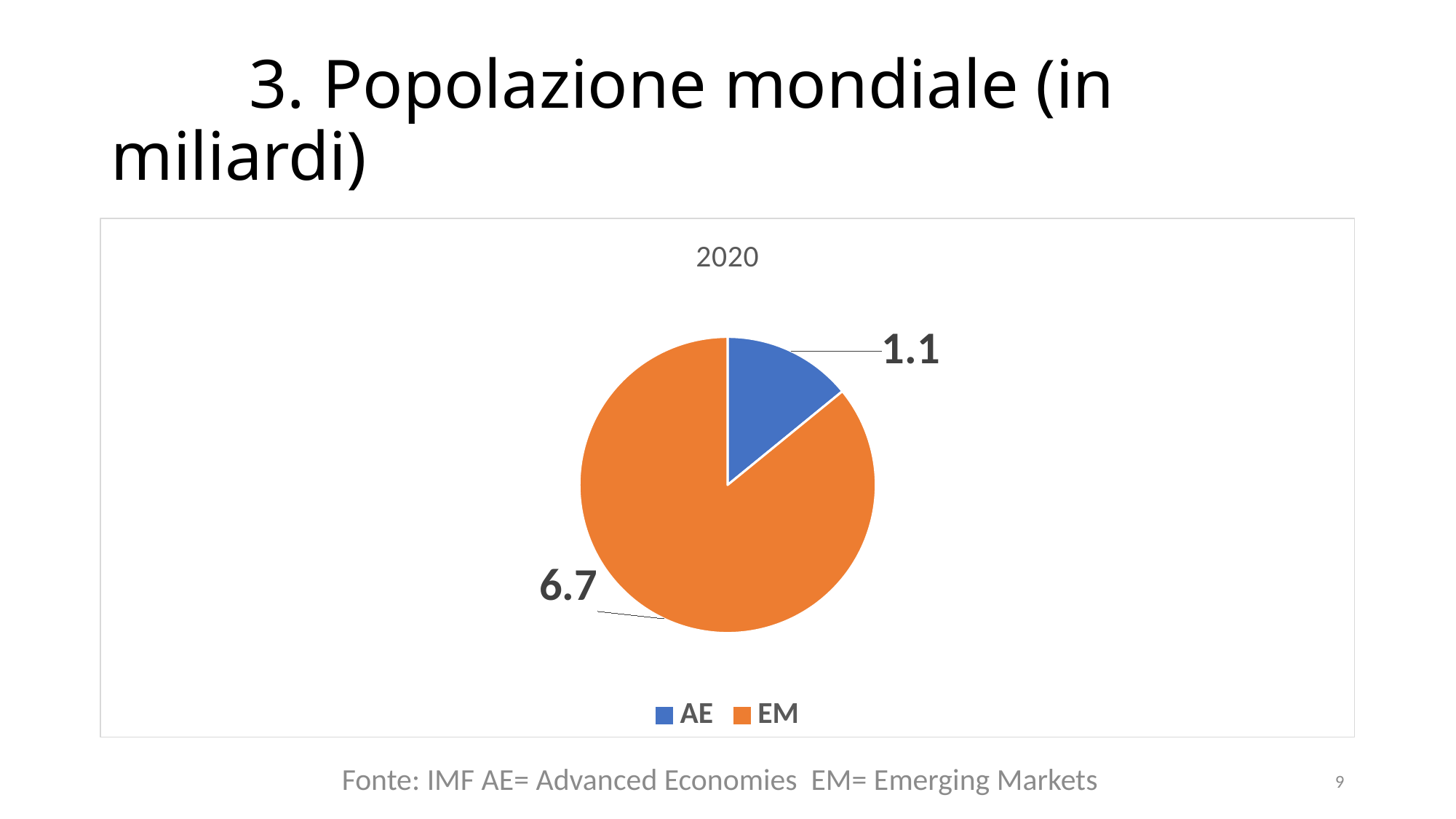
What kind of chart is shown on the slide? pie chart Which is larger, the value for AE or the value for EM? EM What is the value for AE in the pie chart? 1.1 How many slices does the pie chart have? 2 What colour is the EM slice in the pie chart? orange What is the difference between the EM value and the AE value? 5.6 What is the total of the two slices in the pie chart? 7.8 What is the title of the chart? 2020 How many entries does the legend list? 2 Which category has the largest slice of the pie? EM Which category has the smallest slice of the pie? AE What is the value for EM in the pie chart? 6.7